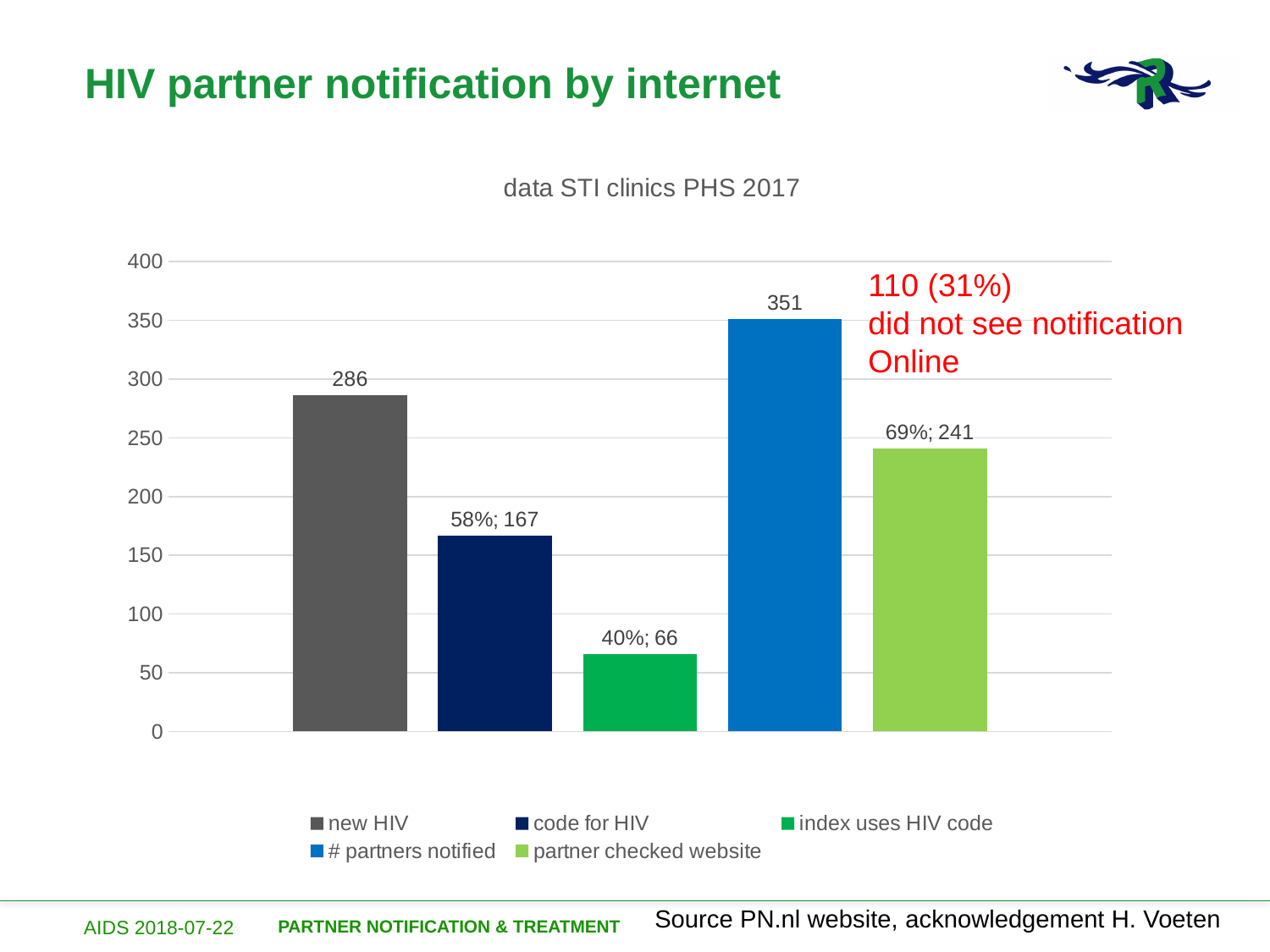
Which series has the highest value? # partners notified What is the value for new HIV? 286 What is the data label shown for partner checked website? 69%; 241 What is the data label shown for code for HIV? 58%; 167 Which is larger, new HIV or code for HIV? new HIV How many series does the legend list? 5 Which series has the lowest value? index uses HIV code What is the difference between # partners notified (351) and partner checked website (241)? 110 What is the data label shown for index uses HIV code? 40%; 66 What kind of chart is shown? bar chart What is the title of the chart? data STI clinics PHS 2017 What is the value for # partners notified? 351